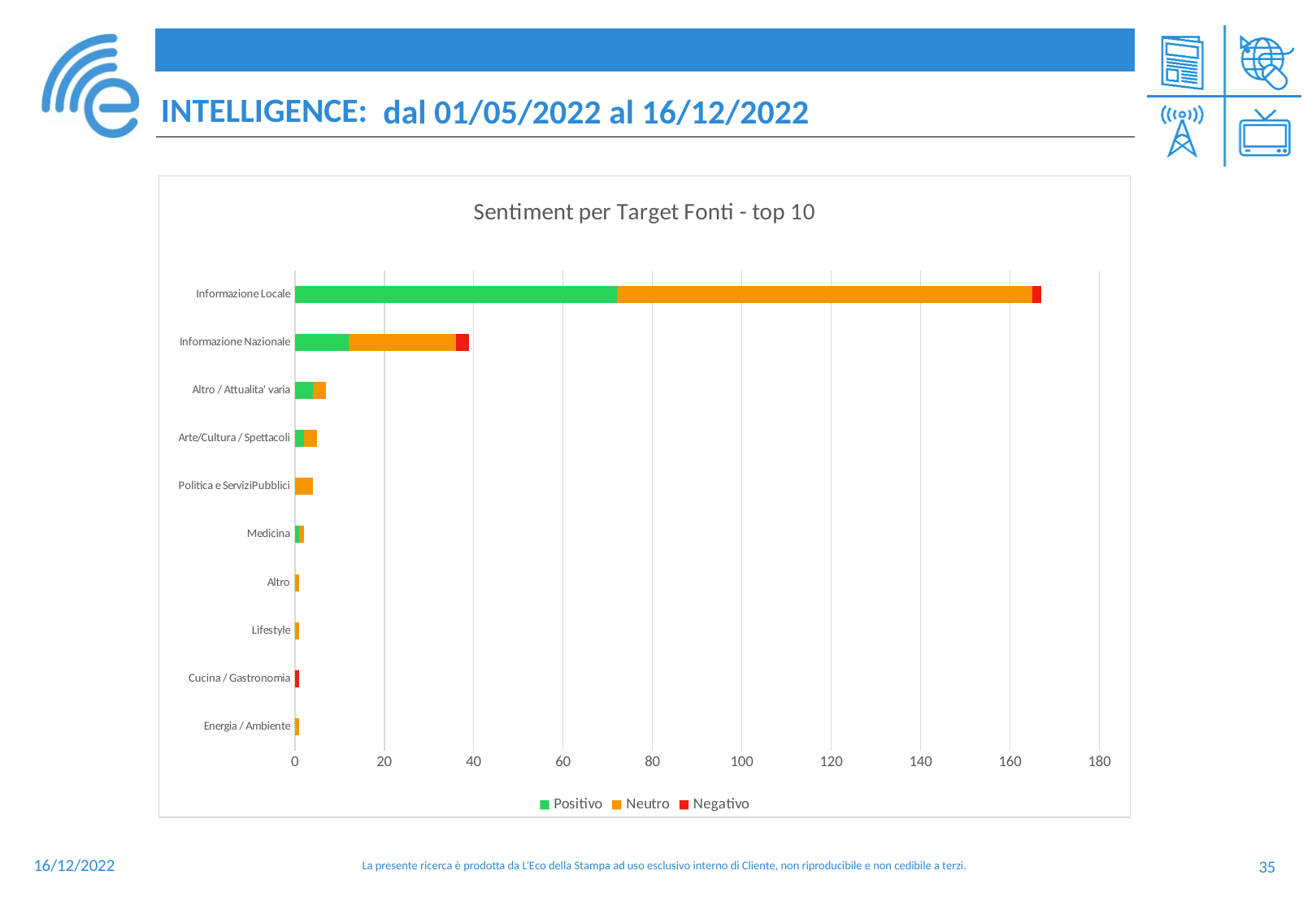
Is the total bar for Informazione Locale greater or less than 160? greater Which has the larger total bar, Informazione Locale or Informazione Nazionale? Informazione Locale How many categories are plotted on the chart? 10 What is the title of the chart? Sentiment per Target Fonti - top 10 What kind of chart is shown on the slide? Stacked bar chart Is the total bar for Altro / Attualita' varia greater or less than 20? less Which category has the longest total bar? Informazione Locale Which series is shown in green in the legend? Positivo Which has the larger total bar, Informazione Nazionale or Politica e ServiziPubblici? Informazione Nazionale Is the Positivo segment for Informazione Locale greater or less than 60? greater How many series does the legend list? 3